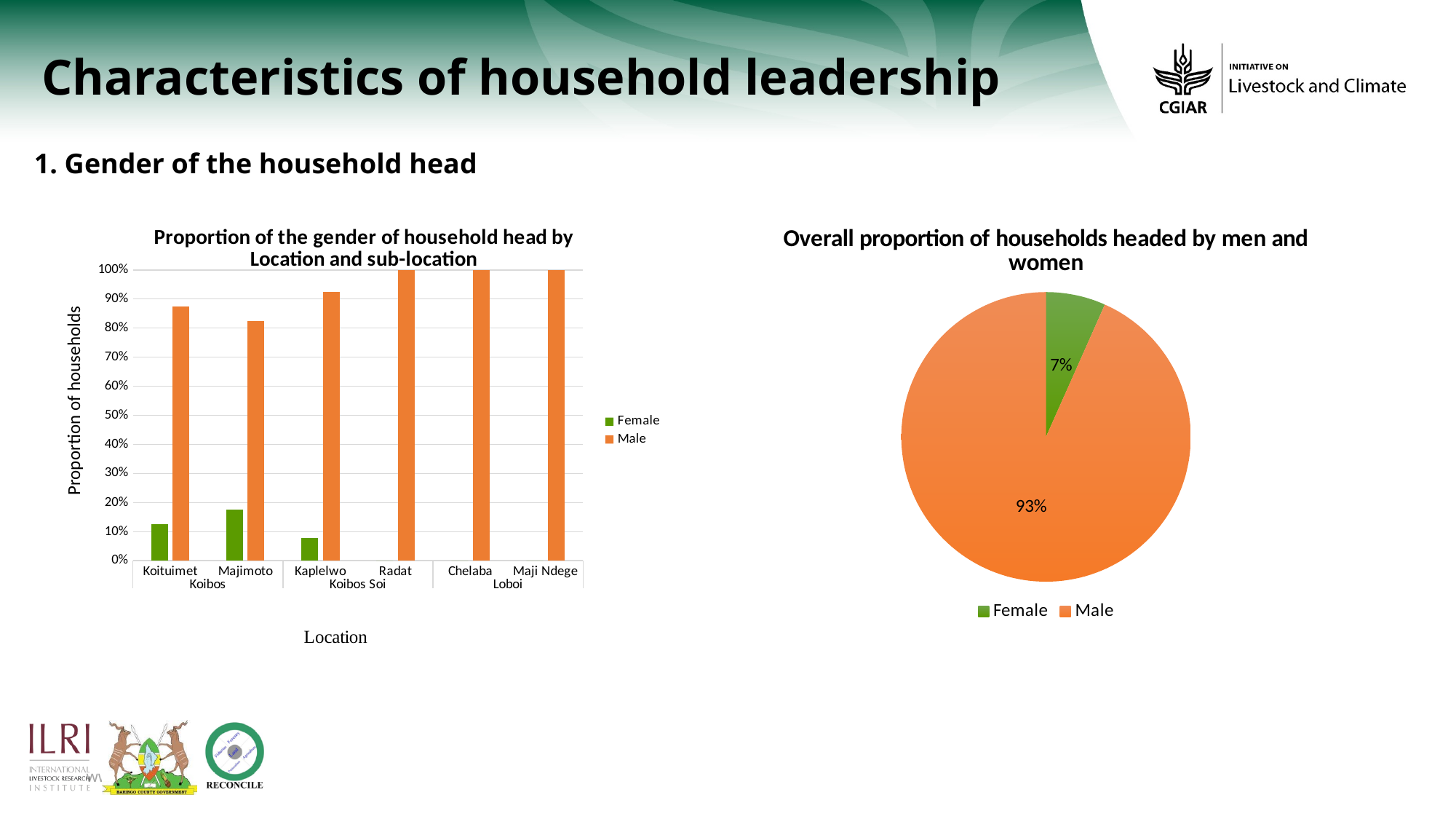
In the bar chart on the left, which sub-location has the highest Female proportion? Majimoto In the bar chart on the left, is the Male value for Koituimet greater or less than 80%? greater In the bar chart on the left, how many series does the legend list? 2 In the bar chart on the left, is the Female value for Majimoto greater or less than 20%? less In the pie chart 'Overall proportion of households headed by men and women', what share of households are headed by men (Male)? 93% What kind of chart is the chart on the left titled 'Proportion of the gender of household head by Location and sub-location'? bar chart How many entries does the legend of the pie chart on the right list? 2 What kind of chart is the chart on the right titled 'Overall proportion of households headed by men and women'? pie chart In the bar chart on the left, how many sub-locations are shown on the x axis? 6 In the bar chart on the left, which is larger: the Female value for Koituimet or the Female value for Kaplelwo? Koituimet In the bar chart on the left, what is the title of the y axis? Proportion of households In the pie chart 'Overall proportion of households headed by men and women', what share of households are headed by women (Female)? 7%